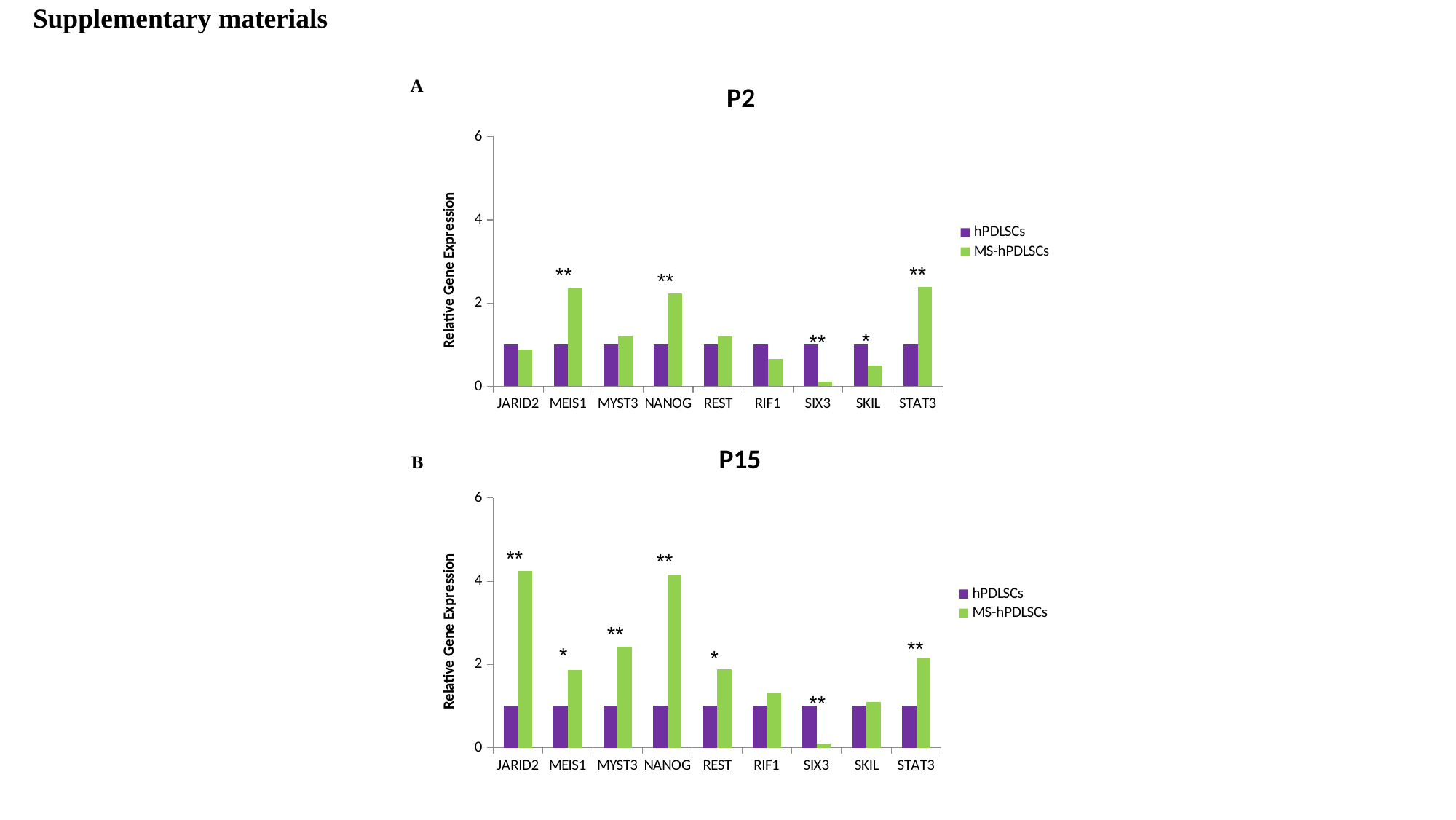
What kind of chart is the P2 chart? Bar chart In the P2 chart, is the MS-hPDLSCs value for MEIS1 greater or less than 2? greater In the P15 chart, is the MS-hPDLSCs value for RIF1 greater or less than 2? less In the P15 chart, which gene has the lowest MS-hPDLSCs value? SIX3 In the P2 chart, how many genes are shown on the x axis? 9 How many series does the legend of the P15 chart list? 2 In the P2 chart, is the MS-hPDLSCs value for SKIL greater or less than 2? less In the P15 chart, which is larger for MS-hPDLSCs: MYST3 or SKIL? MYST3 In the P2 chart, which gene has the lowest MS-hPDLSCs value? SIX3 In the P2 chart, which is larger for MS-hPDLSCs: NANOG or RIF1? NANOG What is the y-axis label of the P15 chart? Relative Gene Expression